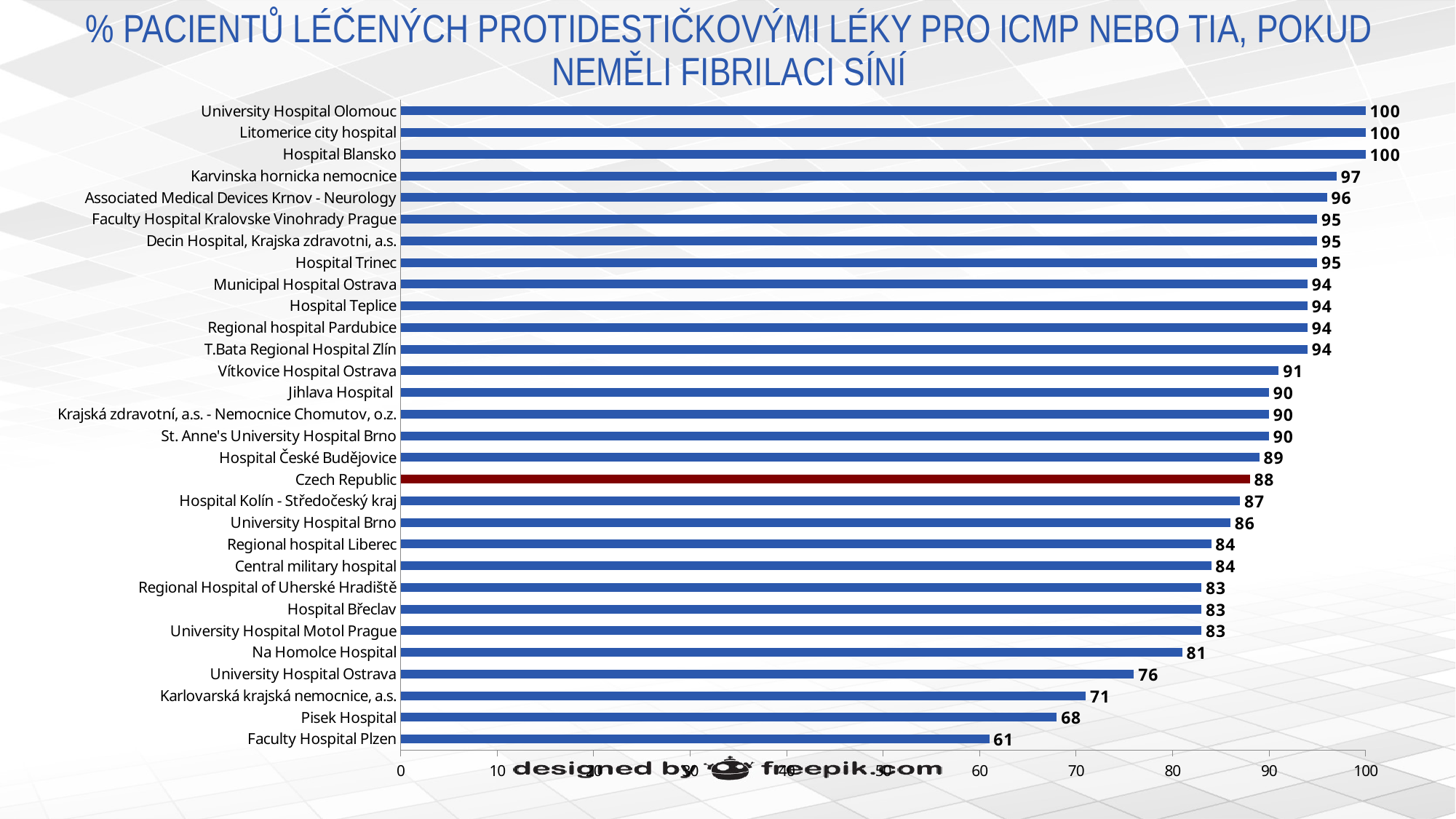
What is the difference between the values for Karvinska hornicka nemocnice and Na Homolce Hospital? 16 What kind of chart is shown on the slide? bar chart Which category has the lowest value? Faculty Hospital Plzen What is the value for University Hospital Ostrava? 76 What is the value for Faculty Hospital Plzen? 61 Which is larger, the value for Jihlava Hospital or the value for University Hospital Brno? Jihlava Hospital What is the value for Vítkovice Hospital Ostrava? 91 Is the value for Karlovarská krajská nemocnice, a.s. greater or less than 80? less Which bar is shown in a different colour (dark red) from the others? Czech Republic What is the difference between the values for Czech Republic and Pisek Hospital? 20 How many categories are shown in the chart? 30 What is the value for Czech Republic? 88